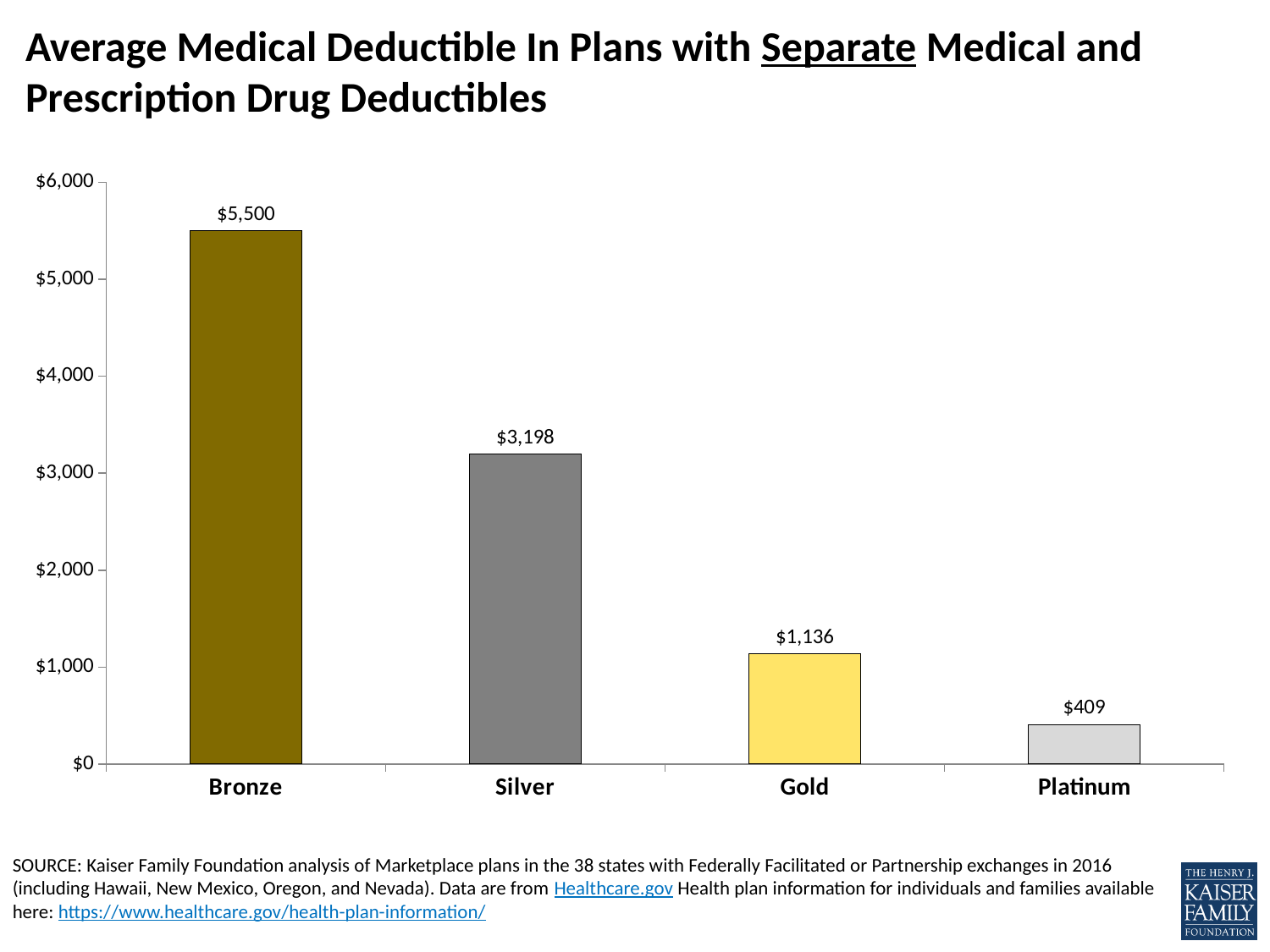
What is the difference between the Gold and Platinum average medical deductibles? $727 What is the average medical deductible for Gold plans? $1,136 What is the average medical deductible for Silver plans? $3,198 What is the difference between the Bronze and Silver average medical deductibles? $2,302 Do the values rise or fall moving from Bronze to Platinum along the x axis? Fall How many plan types are shown on the chart? 4 Which has a larger average medical deductible, Silver or Gold? Silver Which plan type has the highest average medical deductible? Bronze What kind of chart is shown on the slide? Bar chart What is the average medical deductible for Bronze plans? $5,500 Which plan type has the lowest average medical deductible? Platinum What is the average medical deductible for Platinum plans? $409